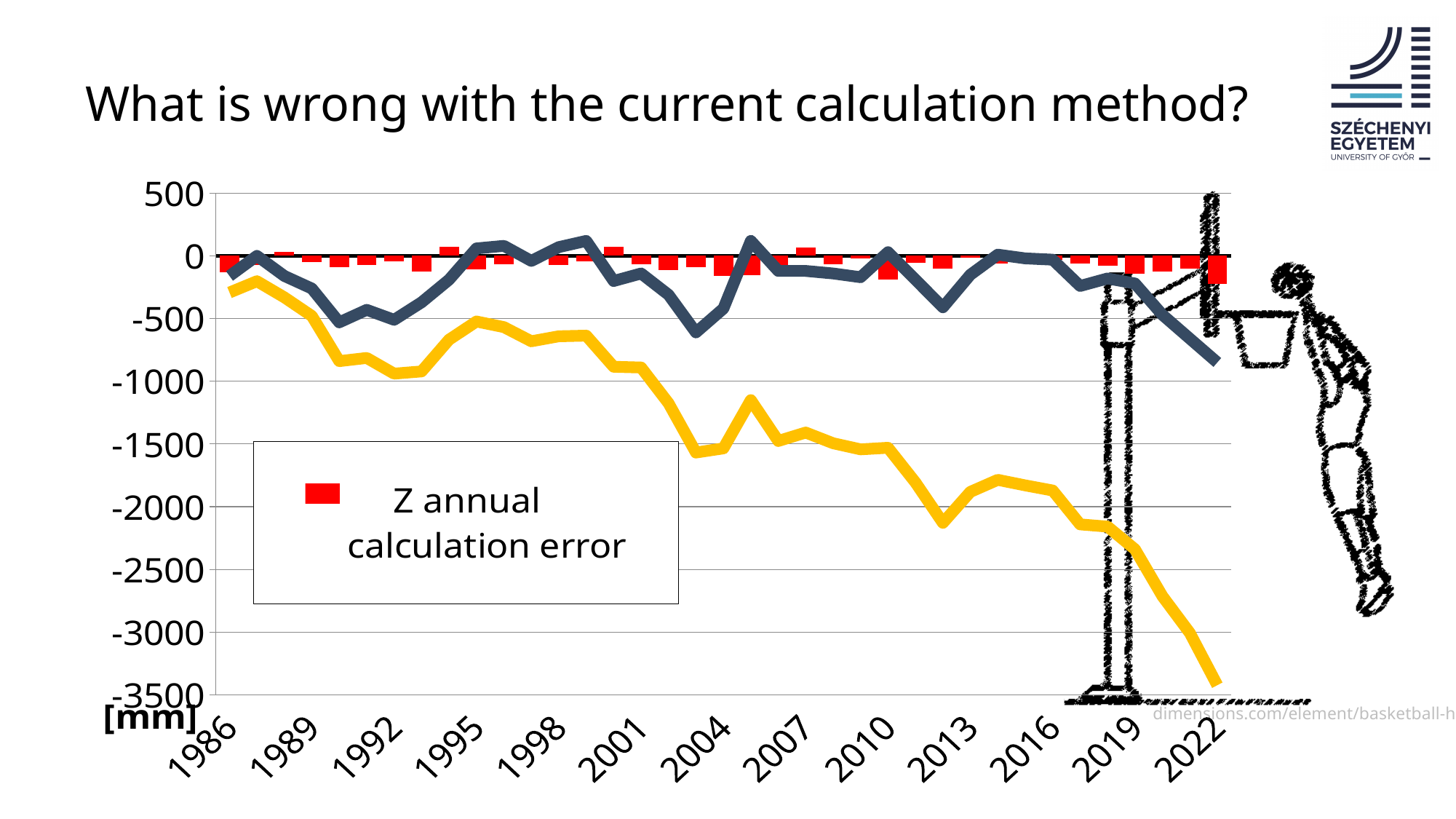
What kind of chart is shown on the slide? a combination chart with bars and lines At 2022, which line has the higher value, the yellow line or the dark blue line? dark blue line Is the value of the yellow line at 2019 greater or less than -1500? less Is the value of the yellow line at 2022 greater or less than -3000? less What unit is shown for the vertical axis? [mm] How many entries does the chart's legend list? 1 How many year labels are shown on the x axis? 13 Is the value of the dark blue line at 2022 greater or less than -500? less What is the name of the series listed in the legend? Z annual calculation error Does the yellow line rise or fall overall from 1986 to 2022? fall